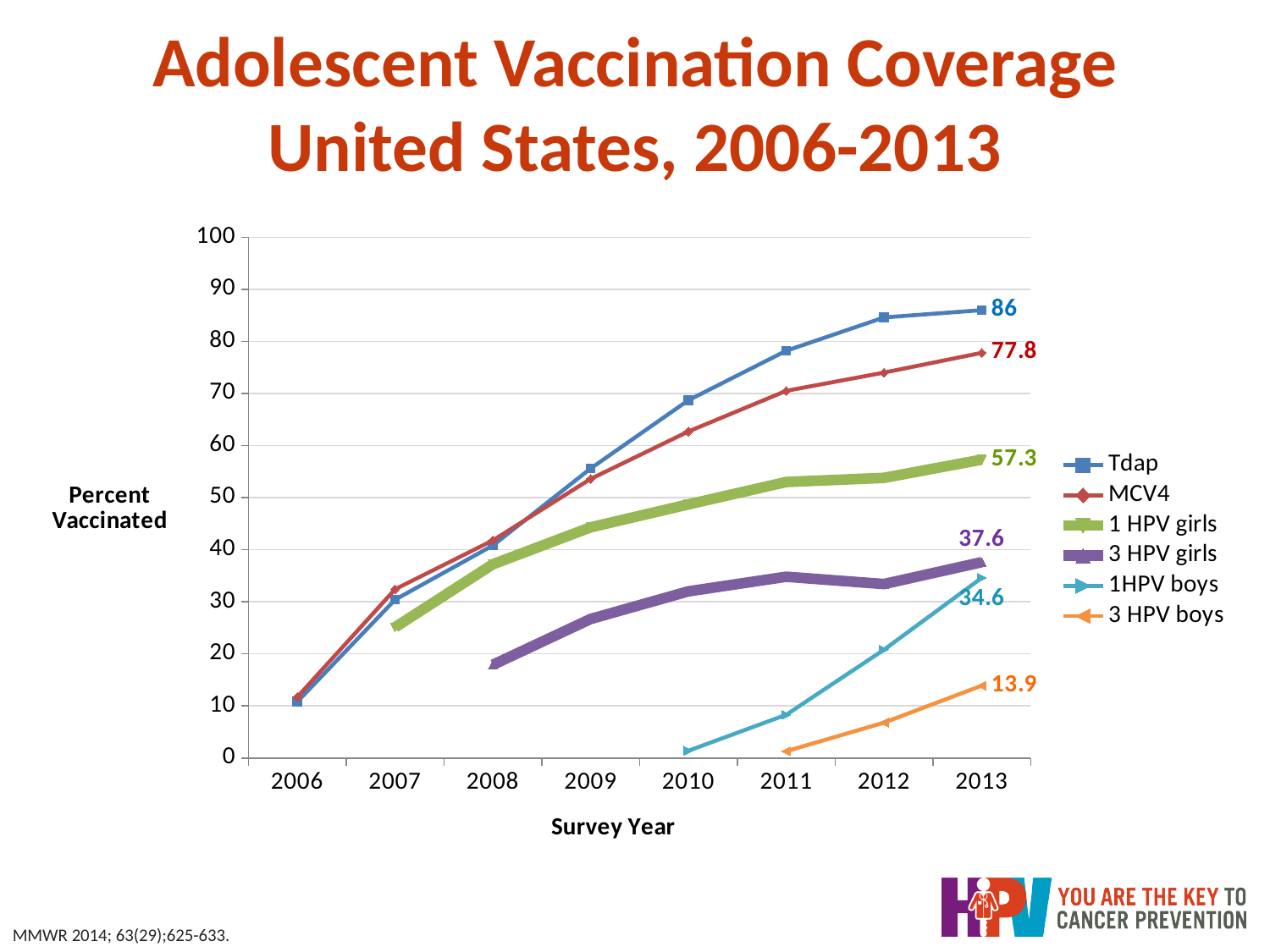
Which series has the lowest value in 2013? 3 HPV boys In 2013, which is larger: 3 HPV girls or 1HPV boys? 3 HPV girls Does the 1 HPV girls series rise or fall from 2007 to 2013? Rise What is the MCV4 vaccination coverage in 2013? 77.8 Which series has the highest value in 2013? Tdap What is the value for 1 HPV girls in 2013? 57.3 What is the difference between the Tdap and MCV4 values in 2013? 8.2 Is the Tdap value for 2010 greater or less than 60? greater What kind of chart is shown on the slide? Line chart What is the Tdap vaccination coverage in 2013? 86 How many series does the legend list? 6 What is the value for 3 HPV boys in 2013? 13.9